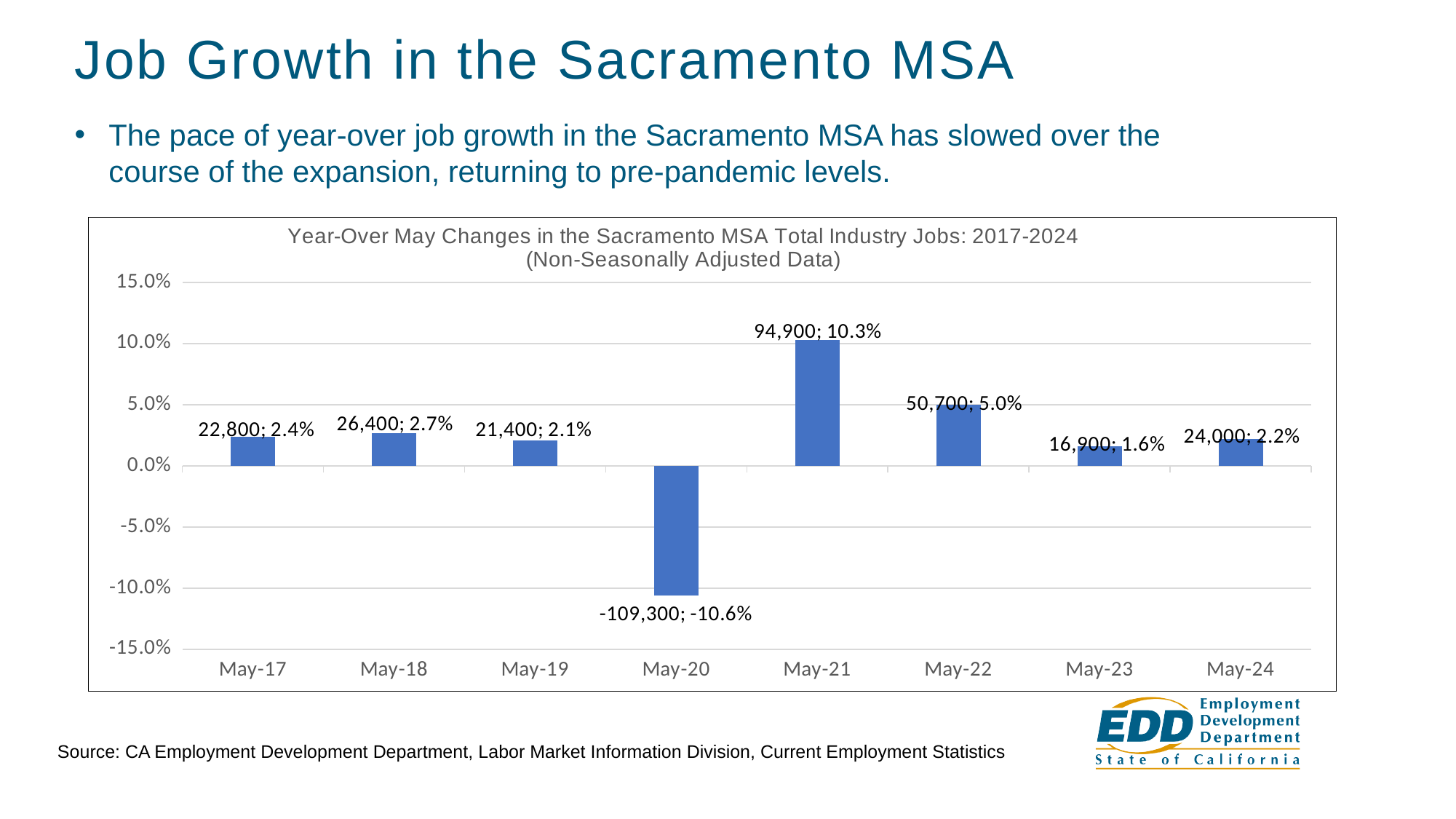
What is the title of the chart? Year-Over May Changes in the Sacramento MSA Total Industry Jobs: 2017-2024 (Non-Seasonally Adjusted Data) What is the job change in number of jobs shown for May-20? -109,300 Which month has the lowest year-over percentage change? May-20 What is the percentage change shown for May-24? 2.2% How many months are plotted on the chart? 8 What is the difference in percentage points between the May-22 and May-23 values? 3.4 percentage points What is the percentage change shown for May-21? 10.3% Which is larger, the percentage change for May-18 or for May-19? May-18 Is the value for May-21 greater or less than 10.0%? greater Which month has the highest year-over percentage change? May-21 What kind of chart is shown on the slide? Bar chart